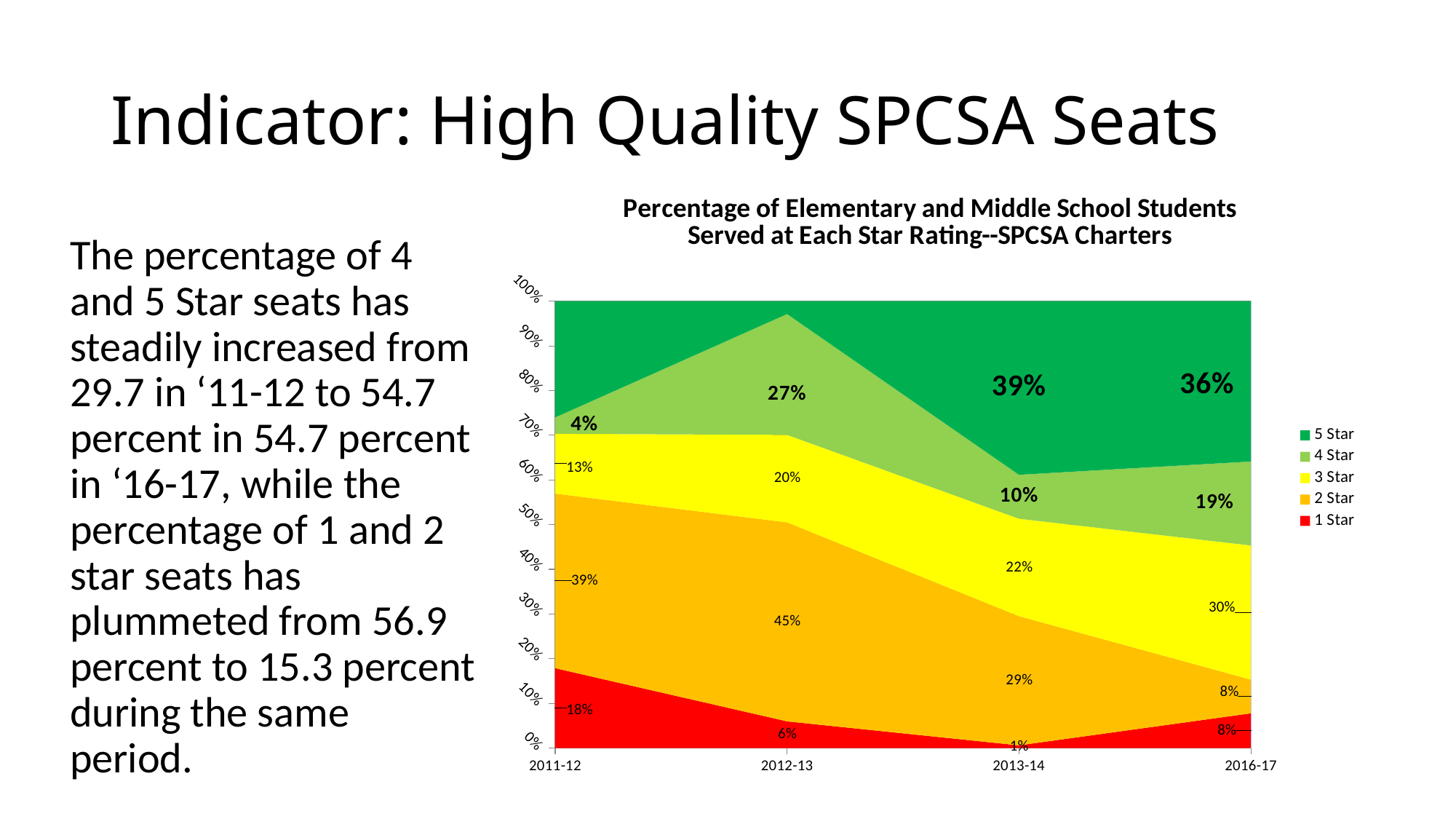
What is the 4 Star value for 2016-17? 19% What percentage of students were in 1 Star schools in 2011-12? 18% In which year was the 1 Star percentage lowest? 2013-14 What kind of chart is shown on the slide? area chart What is the 5 Star value for 2013-14? 39% What percentage of students were served at 2 Star schools in 2012-13? 45% How many series does the legend list? 5 Which year has the larger 3 Star value, 2013-14 or 2016-17? 2016-17 How many school years are shown on the x axis? 4 In which year was the 2 Star percentage highest? 2012-13 By how many percentage points did the 5 Star value change from 2013-14 to 2016-17? 3 percentage points Does the 1 Star percentage rise or fall from 2011-12 to 2013-14? fall